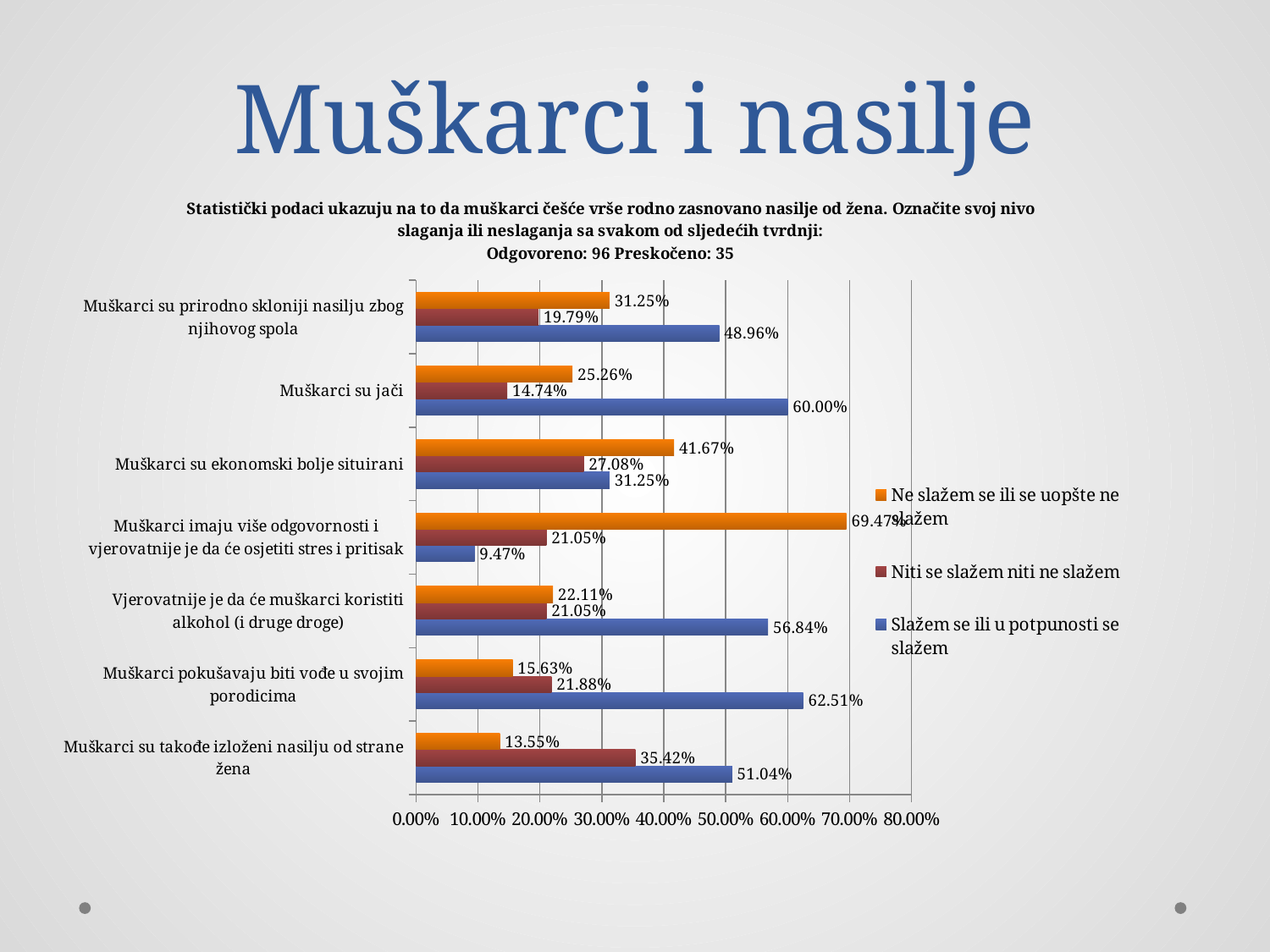
What is the value of "Niti se slažem niti ne slažem" for "Muškarci su takođe izloženi nasilju od strane žena"? 35.42% Which statement has the lowest value for "Slažem se ili u potpunosti se slažem"? Muškarci imaju više odgovornosti i vjerovatnije je da će osjetiti stres i pritisak What is the difference between the "Slažem se ili u potpunosti se slažem" and "Ne slažem se ili se uopšte ne slažem" values for "Muškarci su jači"? 34.74% What is the value of "Slažem se ili u potpunosti se slažem" for "Muškarci su jači"? 60.00% How many series does the legend list? 3 How many statements (categories) are plotted in the chart? 7 What type of chart is shown on the slide? bar chart For "Muškarci su ekonomski bolje situirani", which is larger: "Ne slažem se ili se uopšte ne slažem" or "Slažem se ili u potpunosti se slažem"? Ne slažem se ili se uopšte ne slažem Which statement has the highest value for "Slažem se ili u potpunosti se slažem"? Muškarci pokušavaju biti vođe u svojim porodicima What is the value of "Ne slažem se ili se uopšte ne slažem" for "Muškarci imaju više odgovornosti i vjerovatnije je da će osjetiti stres i pritisak"? 69.47% What colour are the bars for the "Slažem se ili u potpunosti se slažem" series? blue Which statement has the lowest value for "Ne slažem se ili se uopšte ne slažem"? Muškarci su takođe izloženi nasilju od strane žena